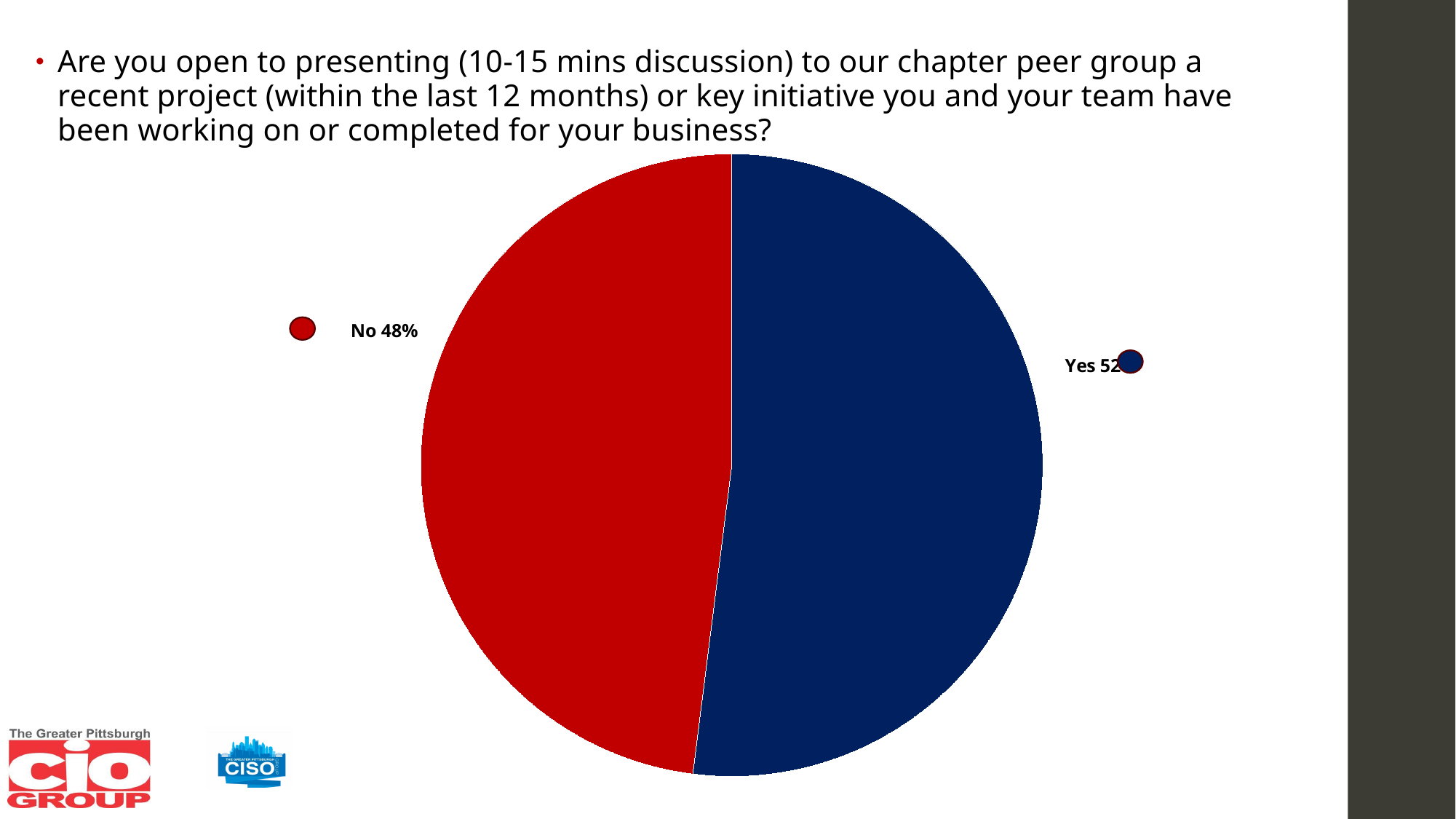
What share of the pie does the No slice represent? 48% What kind of chart is shown on the slide? pie chart What colour is the Yes slice of the pie? dark blue What percentage of respondents answered Yes? 52% By how many percentage points does the Yes share exceed the No share? 4 percentage points Which is larger, the Yes share or the No share? Yes How many slices does the pie chart have? 2 Which response has the smallest share of the pie? No What colour is the No slice of the pie? red What do the two slices of the pie add up to? 100% Which response has the largest share of the pie? Yes What percentage of respondents answered No? 48%